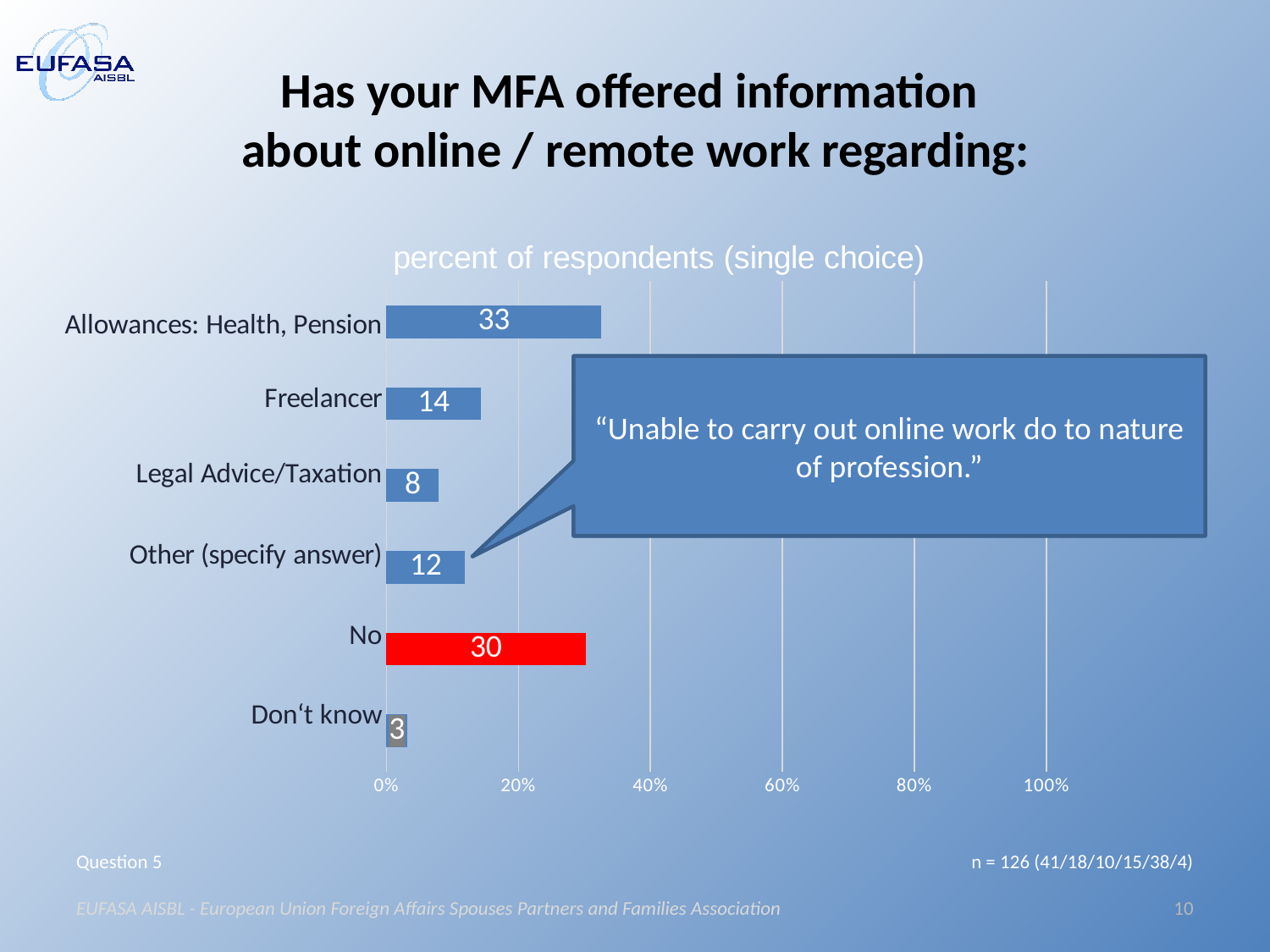
What is the value for Don't know? 3 Which is larger, the value for Freelancer or the value for Legal Advice/Taxation? Freelancer What is the value for Freelancer? 14 What is the title of the chart? percent of respondents (single choice) Which category has the highest value? Allowances: Health, Pension How many categories are shown in the chart? 6 Which category has the lowest value? Don't know What kind of chart is shown on the slide? bar chart What is the difference between the values for Allowances: Health, Pension and No? 3 What is the value for No? 30 What is the value for Allowances: Health, Pension? 33 Is the value for No greater or less than 20%? greater